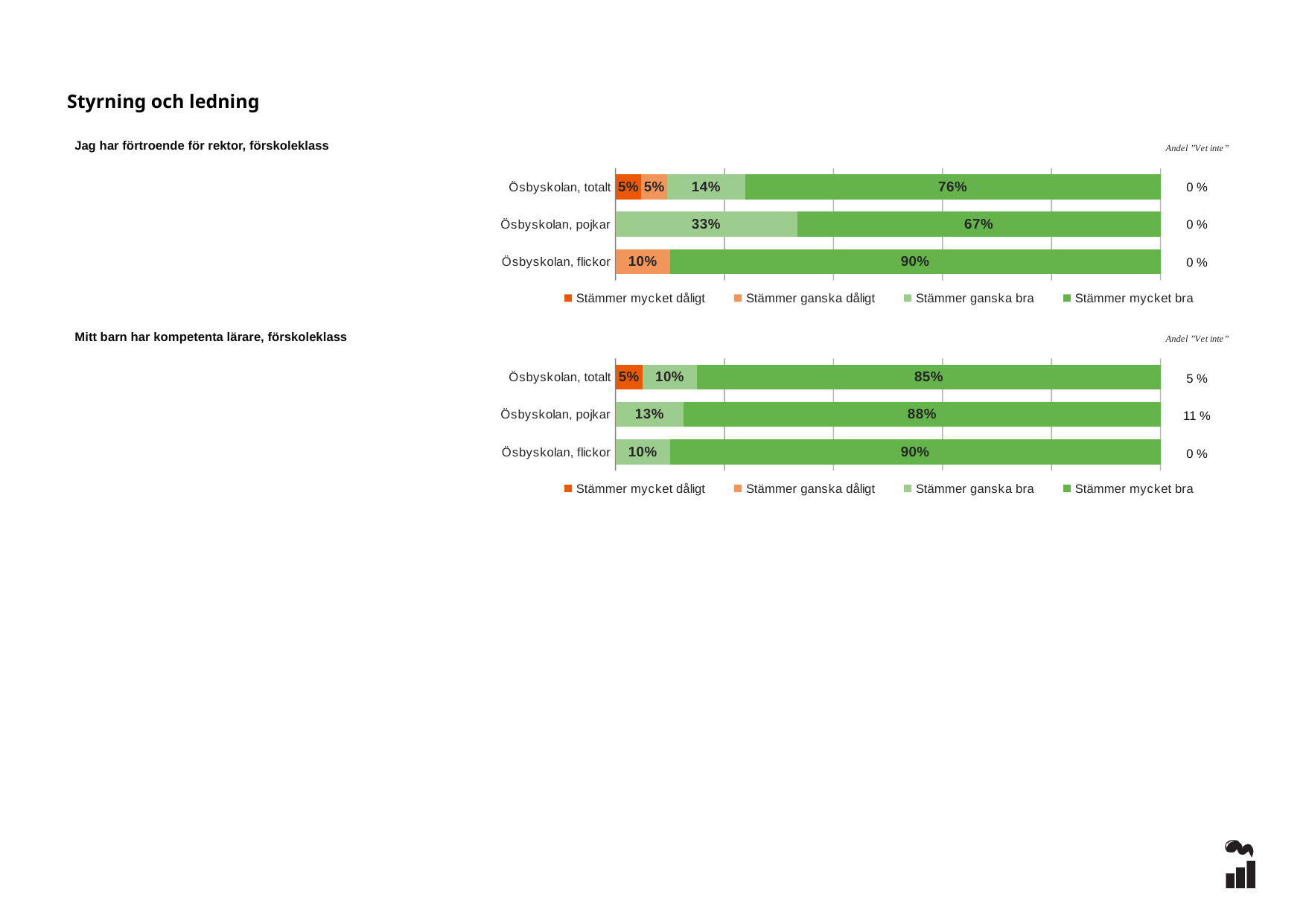
In the chart 'Jag har förtroende för rektor, förskoleklass', what is the 'Stämmer ganska bra' value for Ösbyskolan, pojkar? 33% In the chart 'Jag har förtroende för rektor, förskoleklass', what is the 'Stämmer mycket bra' value for Ösbyskolan, totalt? 76% What kind of chart is 'Mitt barn har kompetenta lärare, förskoleklass'? Stacked bar chart In the chart 'Mitt barn har kompetenta lärare, förskoleklass', which group has the lowest 'Stämmer mycket bra' value? Ösbyskolan, totalt In the chart 'Mitt barn har kompetenta lärare, förskoleklass', what is the 'Andel Vet inte' share for Ösbyskolan, pojkar? 11 % In the chart 'Mitt barn har kompetenta lärare, förskoleklass', what is the 'Stämmer mycket bra' value for Ösbyskolan, pojkar? 88% In the chart 'Mitt barn har kompetenta lärare, förskoleklass', what is the 'Stämmer ganska bra' value for Ösbyskolan, totalt? 10% In the chart 'Jag har förtroende för rektor, förskoleklass', what is the 'Stämmer ganska dåligt' value for Ösbyskolan, flickor? 10% In the chart 'Mitt barn har kompetenta lärare, förskoleklass', is the 'Stämmer mycket bra' value for Ösbyskolan, totalt larger or smaller than for Ösbyskolan, flickor? smaller In the chart 'Jag har förtroende för rektor, förskoleklass', which group has the highest 'Stämmer mycket bra' value? Ösbyskolan, flickor How many series does the legend of the chart 'Jag har förtroende för rektor, förskoleklass' list? 4 In the chart 'Jag har förtroende för rektor, förskoleklass', what is the difference between the 'Stämmer mycket bra' values for Ösbyskolan, flickor and Ösbyskolan, pojkar? 23%